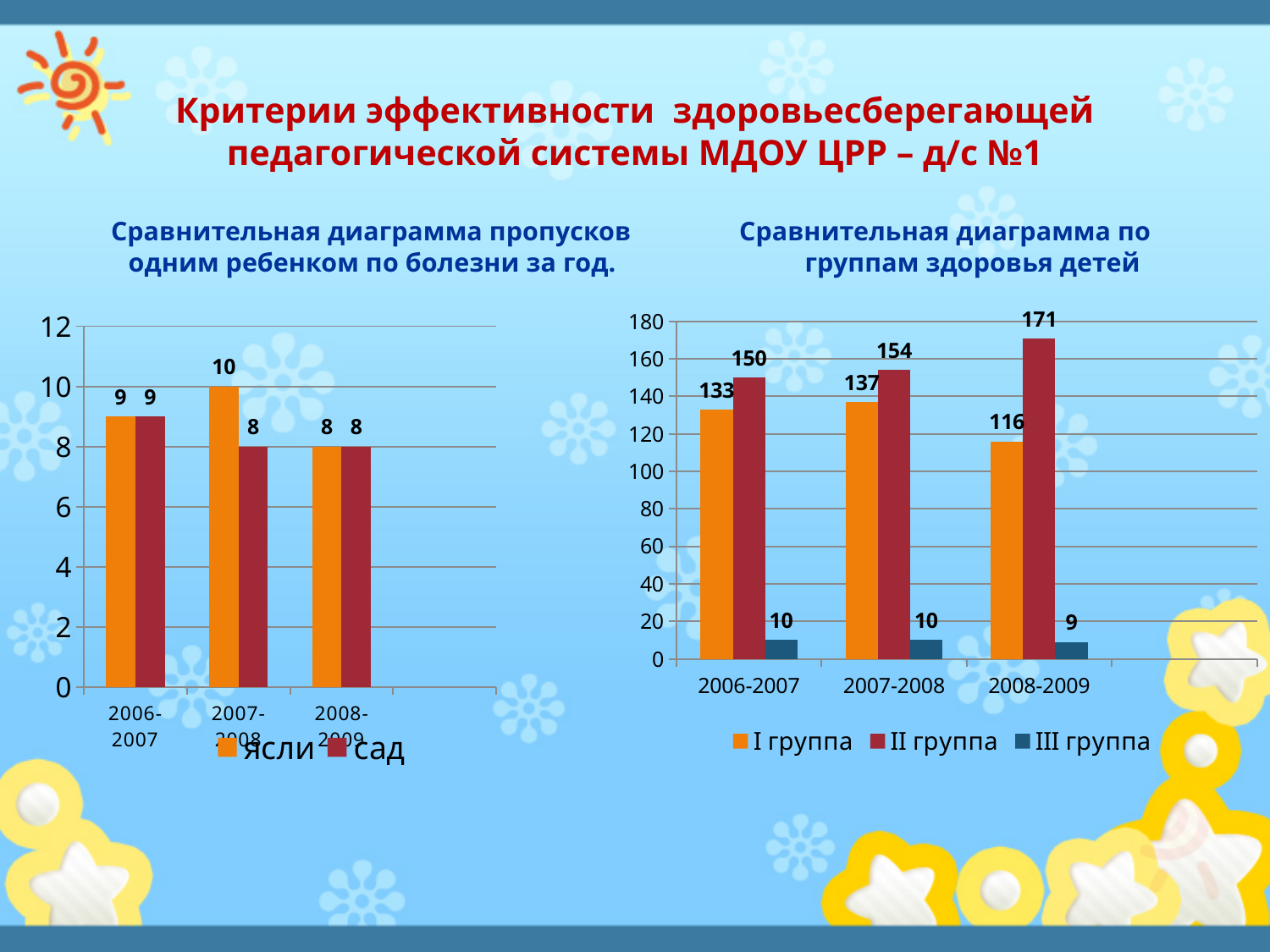
What kind of chart is the right chart? Bar chart In the right chart, which is larger in 2007-2008: I группа or II группа? II группа In the left chart, what is the value for сад in 2006-2007? 9 In the right chart, which year has the lowest value for I группа? 2008-2009 In the left chart, how many series does the legend list? 2 In the left chart, which year has the highest value for ясли? 2007-2008 In the left chart, what is the difference between ясли and сад in 2007-2008? 2 In the right chart, how many series does the legend list? 3 In the right chart, what is the value for I группа in 2006-2007? 133 In the left chart (Сравнительная диаграмма пропусков одним ребенком по болезни за год), what is the value for ясли in 2007-2008? 10 In the right chart (Сравнительная диаграмма по группам здоровья детей), what is the value for II группа in 2008-2009? 171 In the right chart, what is the difference between II группа and I группа in 2008-2009? 55